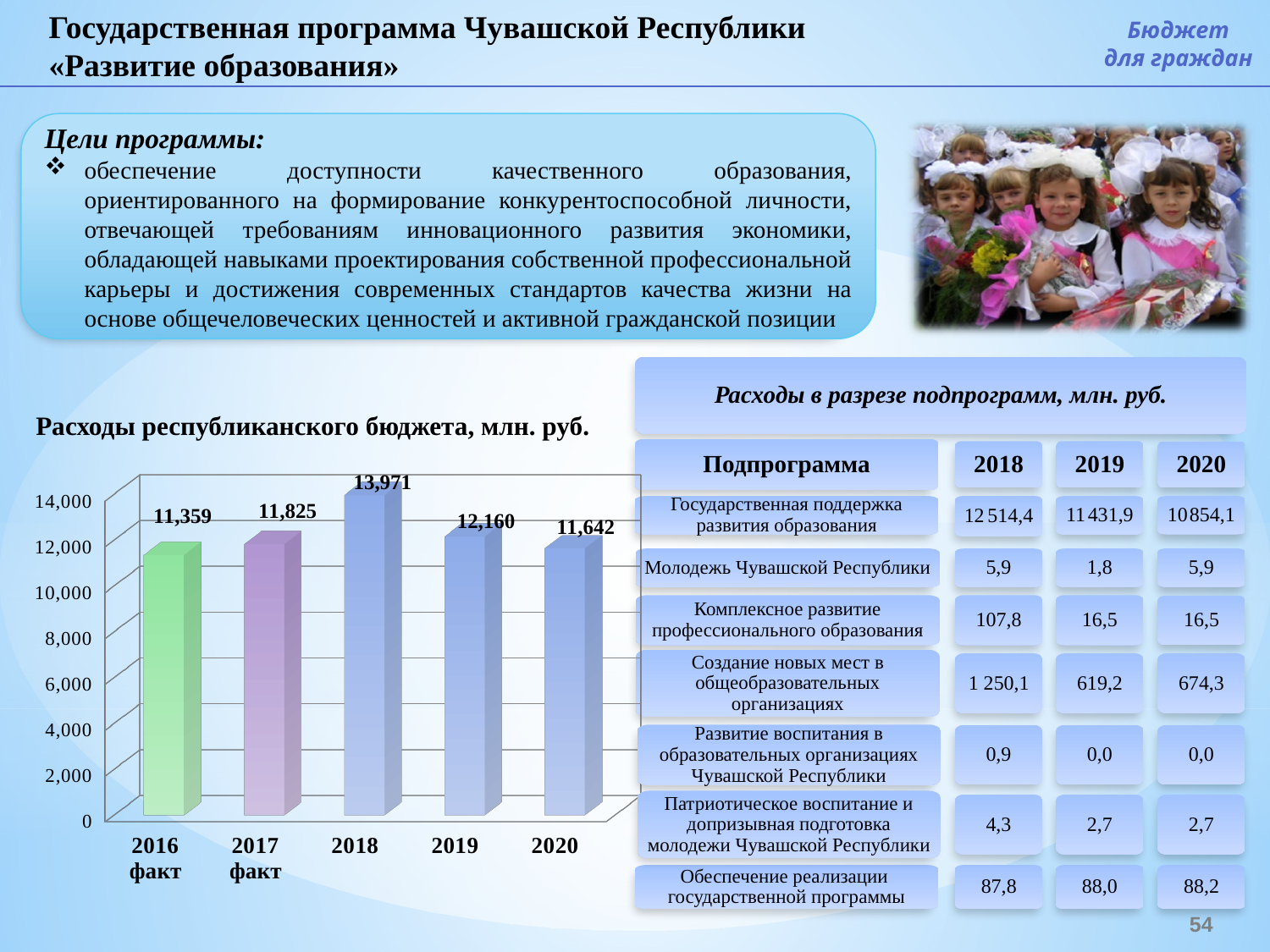
In the chart "Расходы республиканского бюджета, млн. руб.", do the values rise or fall from 2018 to 2020? fall What type of chart is "Расходы республиканского бюджета, млн. руб."? bar chart Which year has the lowest value in the chart "Расходы республиканского бюджета, млн. руб."? 2016 факт In the chart "Расходы республиканского бюджета, млн. руб.", is the value for 2018 greater or less than 12,000? greater What is the value for 2018 in the chart "Расходы республиканского бюджета, млн. руб."? 13,971 What is the difference between the 2018 and 2019 values in the chart "Расходы республиканского бюджета, млн. руб."? 1,811 In the chart "Расходы республиканского бюджета, млн. руб.", which is larger: the value for 2019 or the value for 2020? 2019 What is the value for 2020 in the chart "Расходы республиканского бюджета, млн. руб."? 11,642 Which year has the highest value in the chart "Расходы республиканского бюджета, млн. руб."? 2018 How many bars are shown in the chart "Расходы республиканского бюджета, млн. руб."? 5 What is the difference between the 2017 факт and 2016 факт values in the chart "Расходы республиканского бюджета, млн. руб."? 466 What is the value for 2016 факт in the chart "Расходы республиканского бюджета, млн. руб."? 11,359